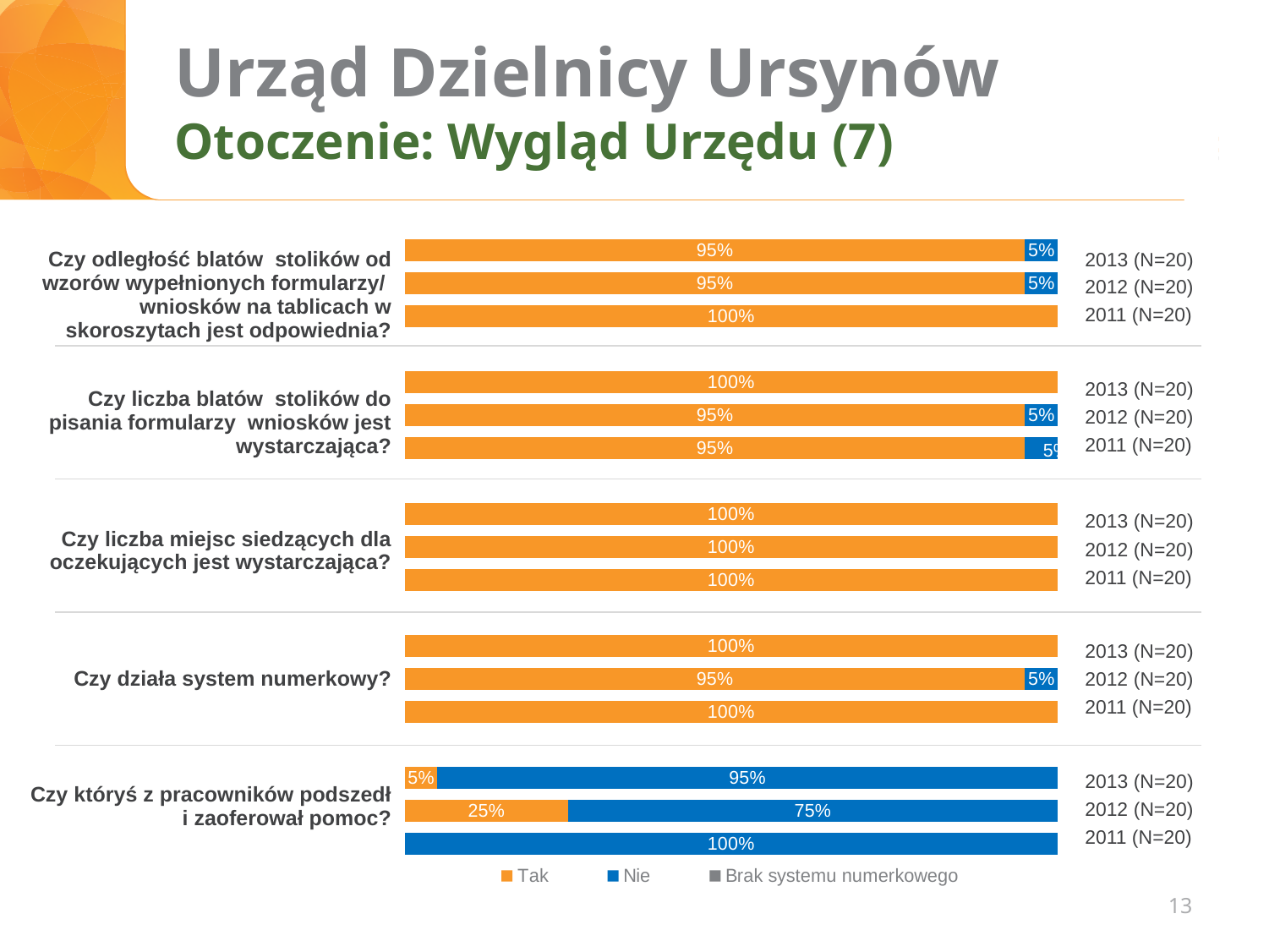
In the chart for "Czy któryś z pracowników podszedł i zaoferował pomoc?", which year has the highest "Tak" value? 2012 (N=20) In the chart for "Czy działa system numerkowy?", is the "Tak" value for 2013 (N=20) larger or smaller than for 2012 (N=20)? larger In the chart for "Czy któryś z pracowników podszedł i zaoferował pomoc?", what is the difference between the "Nie" values for 2013 (N=20) and 2012 (N=20)? 20% In the chart for "Czy któryś z pracowników podszedł i zaoferował pomoc?", what is the total of the 2012 (N=20) bar? 100% In the chart for "Czy odległość blatów stolików od wzorów wypełnionych formularzy/wniosków na tablicach w skoroszytach jest odpowiednia?", what is the "Tak" value for 2011 (N=20)? 100% In the chart for "Czy liczba blatów stolików do pisania formularzy wniosków jest wystarczająca?", what is the "Nie" value for 2012 (N=20)? 5% In the chart for "Czy liczba miejsc siedzących dla oczekujących jest wystarczająca?", how many years are shown? 3 What kind of chart is used on this slide? Stacked bar chart In the chart for "Czy któryś z pracowników podszedł i zaoferował pomoc?", what is the "Nie" value for 2012 (N=20)? 75% In the chart for "Czy któryś z pracowników podszedł i zaoferował pomoc?", what is the "Tak" value for 2013 (N=20)? 5% In the chart for "Czy działa system numerkowy?", what is the "Tak" value for 2012 (N=20)? 95% How many series does the legend at the bottom of the slide list? 3